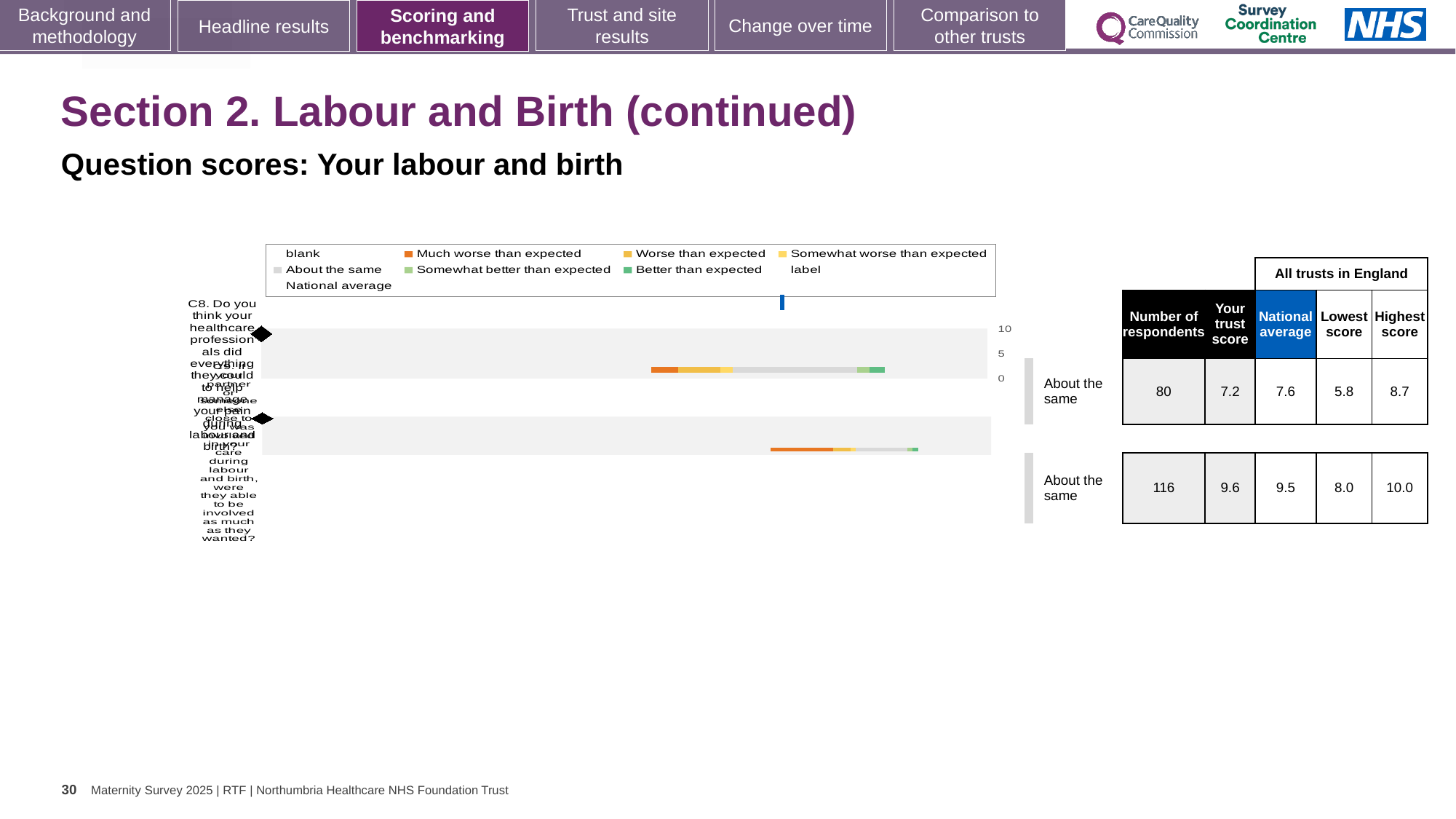
In the chart legend, which label is shown with the orange colour? Much worse than expected What is the highest score across all trusts in England for the second row of the chart? 10.0 What is the national average for the first row (C8)? 7.6 What kind of chart is shown on the slide? bar chart How many question rows (bars) does the chart show? 2 How many respondents are listed for the second row of the chart? 116 What is the 'Your trust score' for the first row (C8, managing pain during labour and birth)? 7.2 For the first row (C8), which is larger: the trust score or the national average? National average What is the difference between the highest score (8.7) and the lowest score (5.8) for the first row (C8)? 2.9 In the chart legend, which label is shown with the dark green colour? Better than expected Which row of the chart has the higher 'Your trust score'? The second row (9.6) What is the difference between the trust score and the national average for the second row of the chart? 0.1